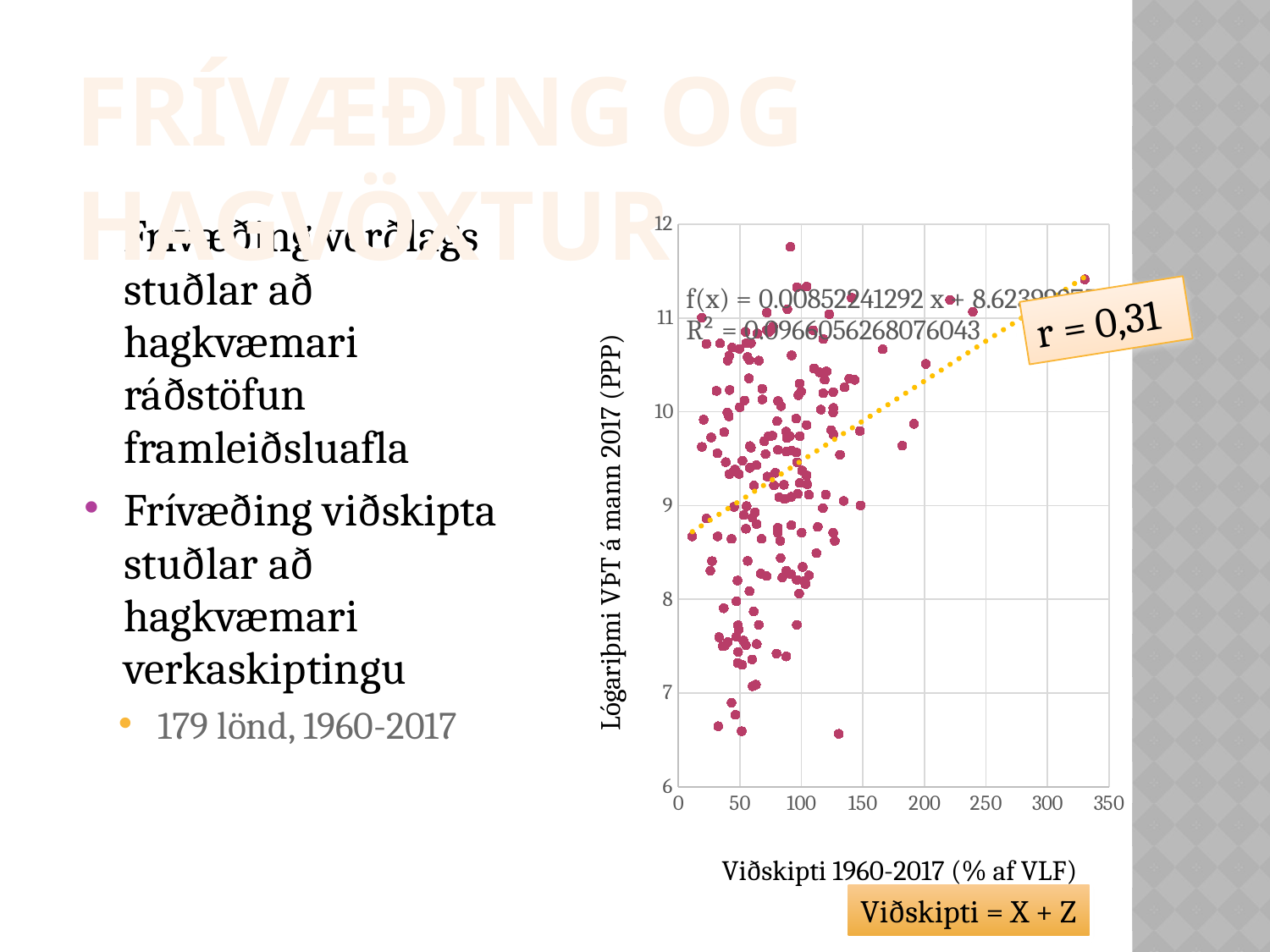
What is the label of the y axis of the chart? Lógariþmi VÞT á mann 2017 (PPP) Is the y value of the trend line at x = 0 greater or less than 9? less What is the label of the x axis of the chart? Viðskipti 1960-2017 (% af VLF) What correlation coefficient r is shown in the callout on the chart? r = 0,31 What is the lowest value shown on the y axis of the chart? 6 Is the x value of the rightmost point on the chart greater or less than 300? greater Is the y value of the highest point on the chart greater or less than 11? greater What is the highest value shown on the x axis of the chart? 350 What kind of chart is shown on the slide? Scatter plot What is the slope of the fitted trend line f(x) shown on the chart? 0.00852241292 Does the dotted trend line rise or fall as the x-axis value increases? Rises